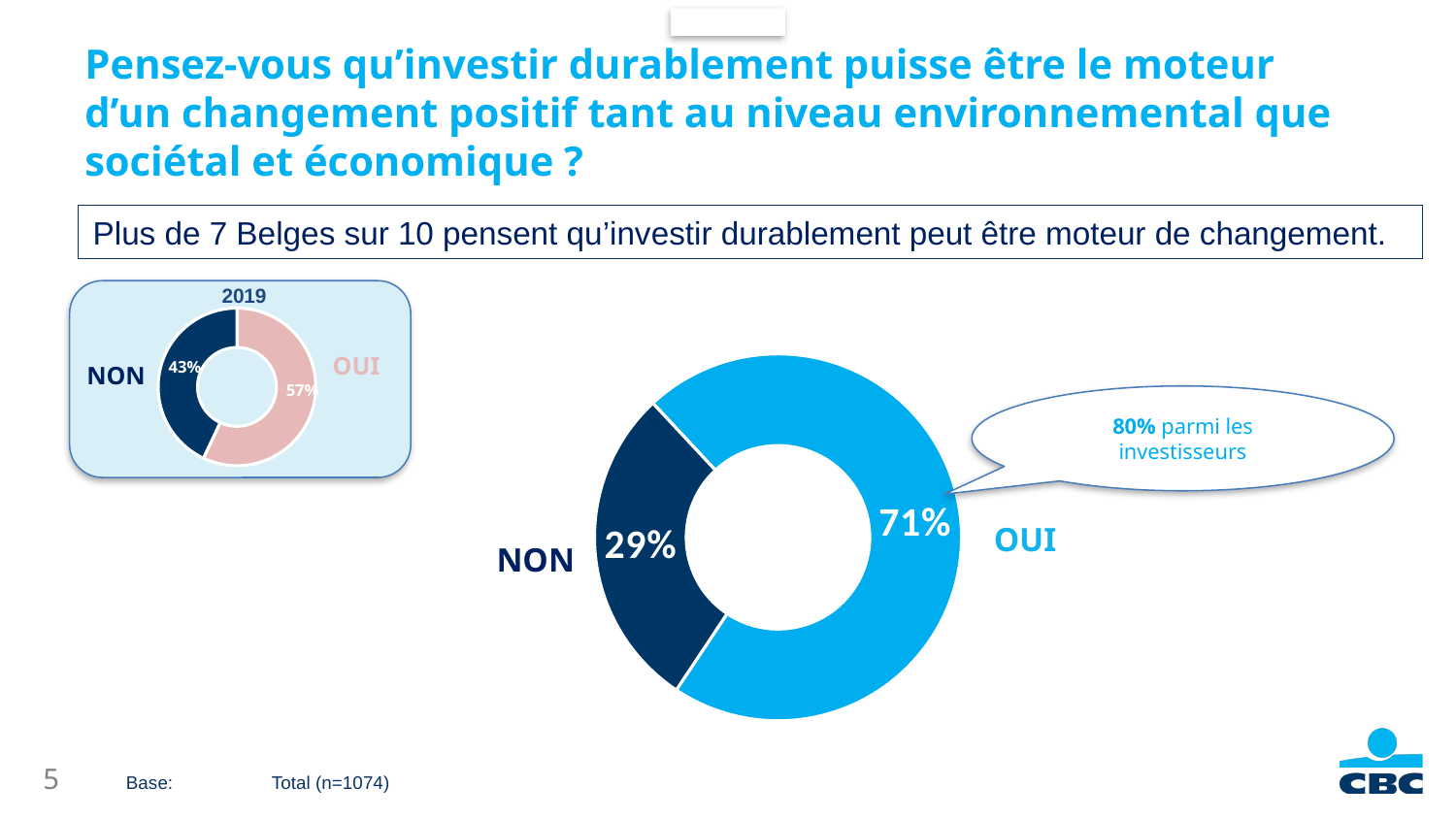
In the small 2019 donut chart, what percentage answered NON? 43% In the large donut chart, what is the difference between the OUI and NON shares? 42 percentage points Is the OUI share larger in the large donut chart or in the small 2019 donut chart? The large donut chart In the large donut chart, what percentage answered OUI? 71% In the small 2019 donut chart, what is the difference between the OUI and NON shares? 14 percentage points In the large donut chart, what percentage answered NON? 29% In the small 2019 donut chart, which category has the smallest share? NON What type of chart is the large chart in the centre of the slide? Donut (pie) chart What year is shown as the title of the small donut chart on the left? 2019 In the small 2019 donut chart, what percentage answered OUI? 57% How many categories does the large donut chart show? 2 In the large donut chart, which category has the largest share? OUI